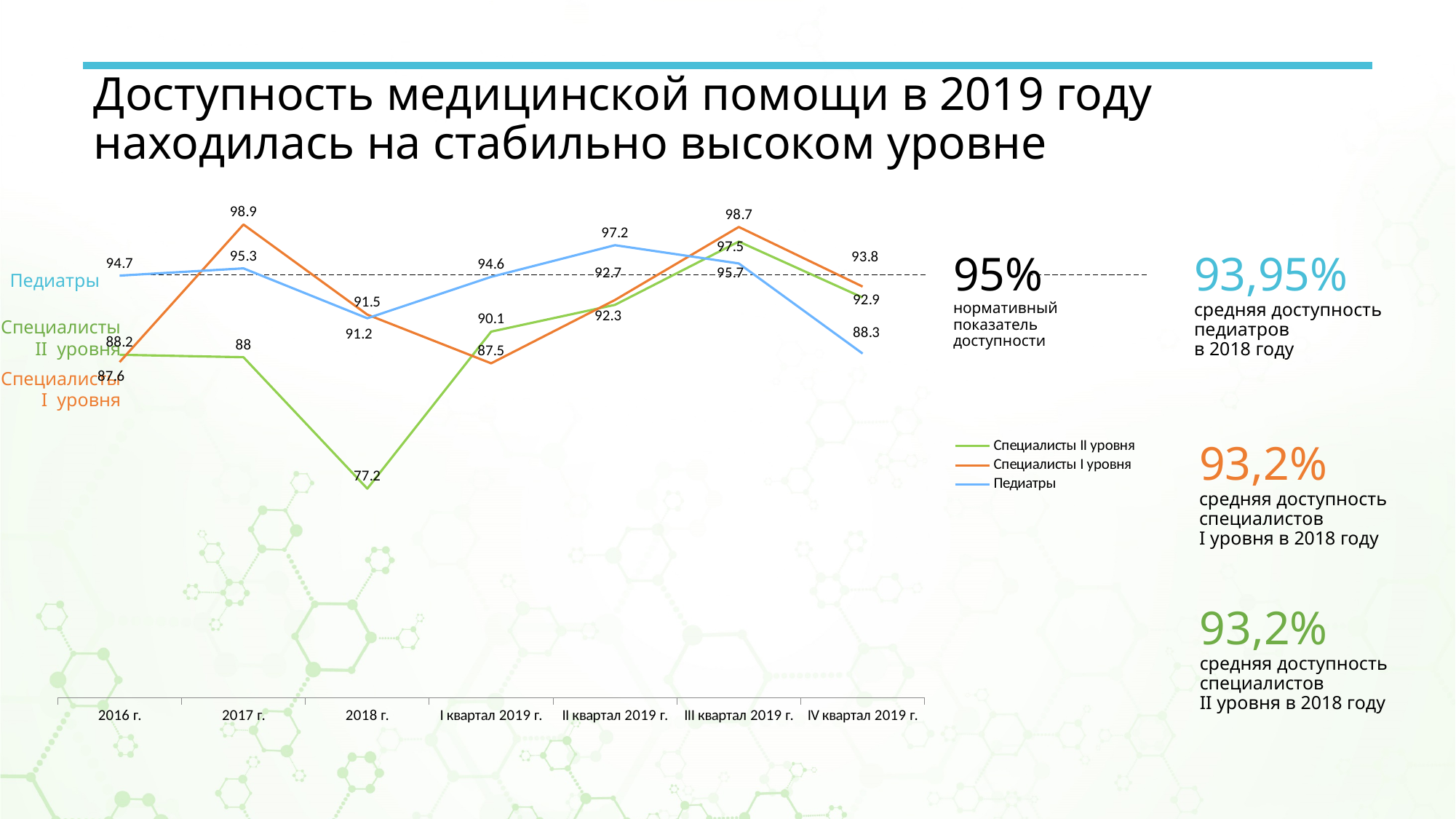
What is the value for Специалисты I уровня in 2017 г.? 98.9 In III квартал 2019 г., which is larger: Специалисты I уровня or Педиатры? Специалисты I уровня How many periods are shown on the x axis? 7 What is the difference between the Специалисты I уровня values in 2017 г. and 2018 г.? 7.4 What is the value for Специалисты II уровня in IV квартал 2019 г.? 92.9 How many series does the legend list? 3 What kind of chart is shown on the slide? Line chart Does the Специалисты II уровня series rise or fall from 2018 г. to III квартал 2019 г.? Rise In which period does the Специалисты II уровня series reach its lowest value? 2018 г. What value does the dashed horizontal line (нормативный показатель доступности) mark? 95% In which period does the Педиатры series reach its highest value? II квартал 2019 г. What is the value for Педиатры in 2017 г.? 95.3